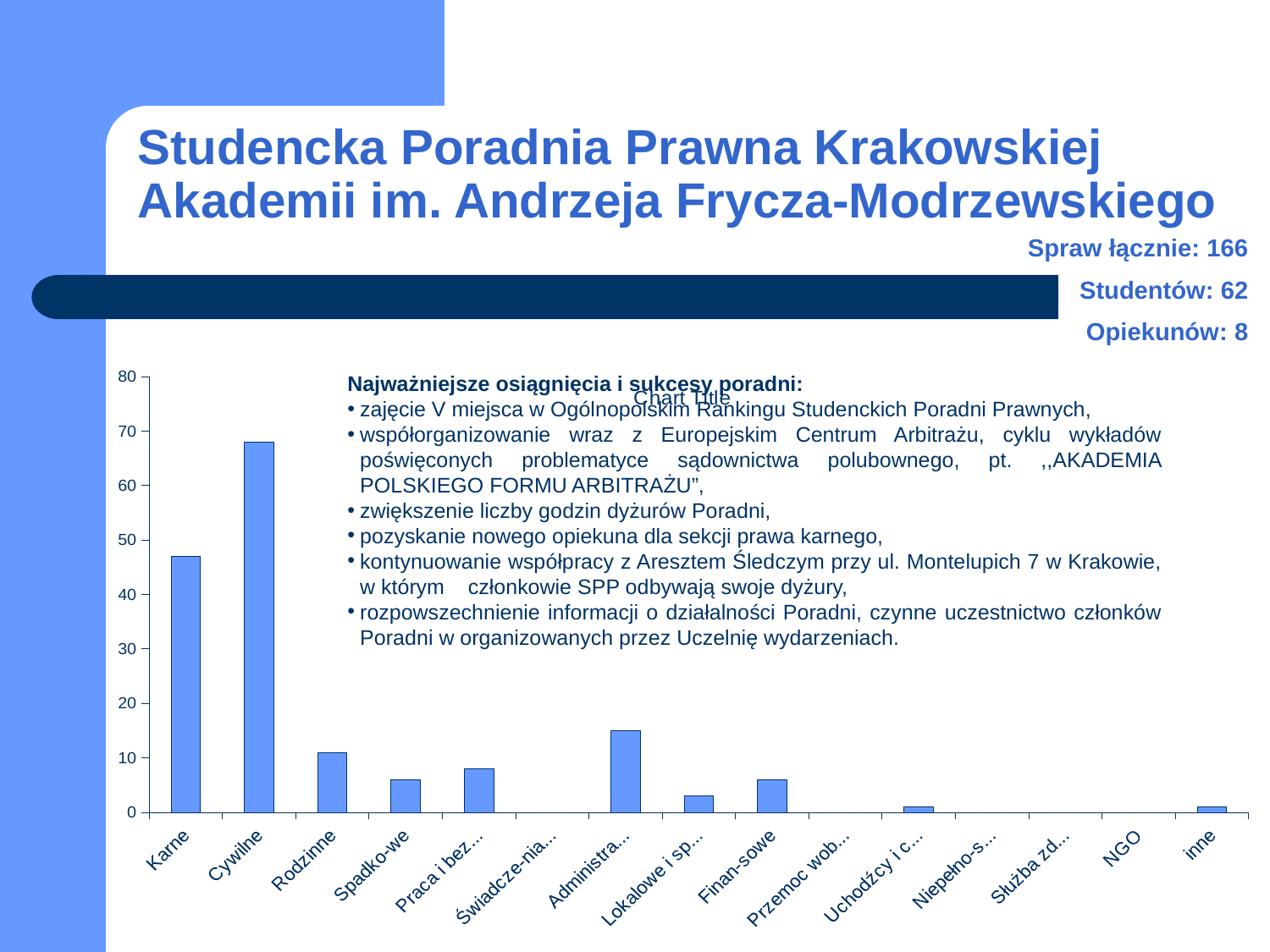
Is the value for Karne greater or less than 40? greater What is the title shown on the chart? Chart Title What kind of chart is shown on the slide? bar chart Is the value for Administra... greater or less than 10? greater Is the value for Rodzinne greater or less than 20? less Which is larger, the value for Karne or the value for Rodzinne? Karne Which category has the highest bar in the chart? Cywilne Which is larger, the value for Karne or the value for Cywilne? Cywilne Which is larger, the value for Rodzinne or the value for Administra...? Administra... How many categories are shown on the x axis of the chart? 15